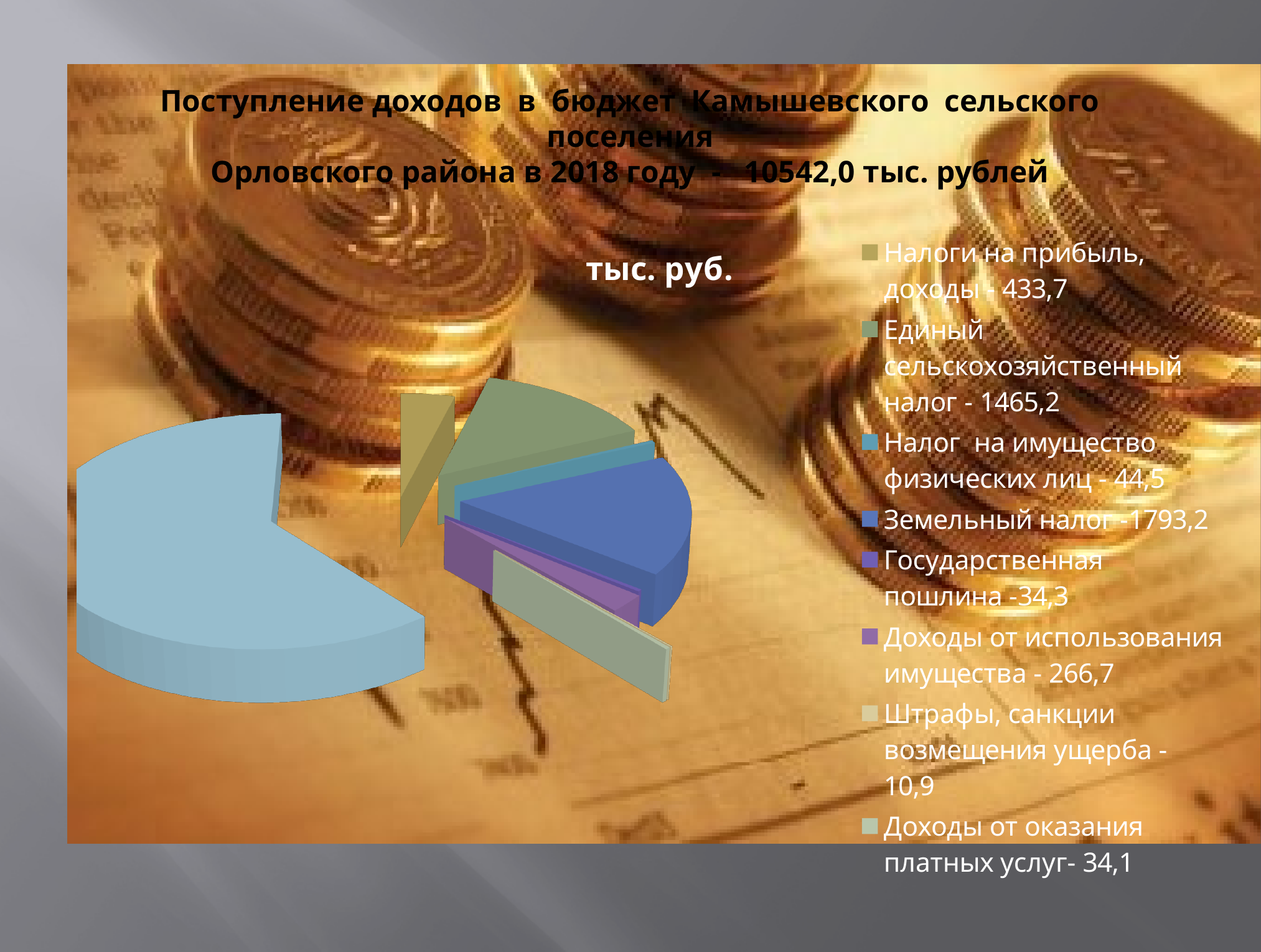
What kind of chart is shown on the slide? pie chart Which is larger: Налог на имущество физических лиц or Государственная пошлина? Налог на имущество физических лиц What is the value for Налоги на прибыль, доходы? 433,7 Which legend category has the lowest value? Штрафы, санкции возмещения ущерба What is the value for Единый сельскохозяйственный налог? 1465,2 What is the title of the chart? тыс. руб. What is the difference between the values for Земельный налог and Единый сельскохозяйственный налог? 328,0 What is the value for Земельный налог? 1793,2 What is the value for Штрафы, санкции возмещения ущерба? 10,9 Which legend category has the highest value? Земельный налог What is the value for Доходы от использования имущества? 266,7 How many categories does the legend list? 8